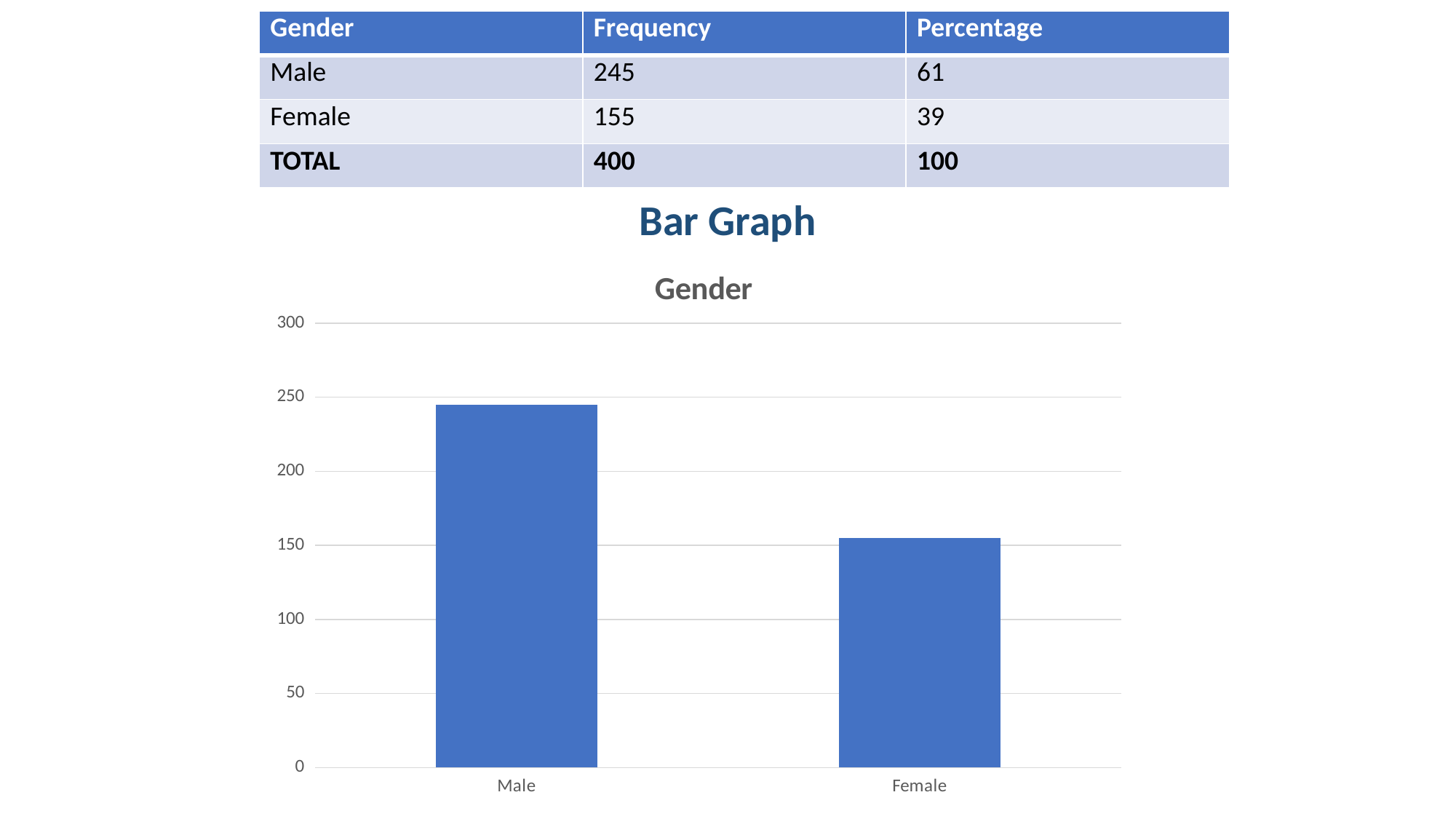
How many categories are shown on the x axis of the chart? 2 What is the frequency value plotted for Female in the chart? 155 Is the value for Male greater or less than 200? greater Is the value for Female greater or less than 200? less What is the frequency value plotted for Male in the chart? 245 Which is larger, the bar for Male or the bar for Female? Male What type of chart is shown on the slide? bar chart What is the title of the chart? Gender Is the value for Male greater or less than 250? less Which category has the lowest bar in the chart? Female Which category has the highest bar in the chart? Male